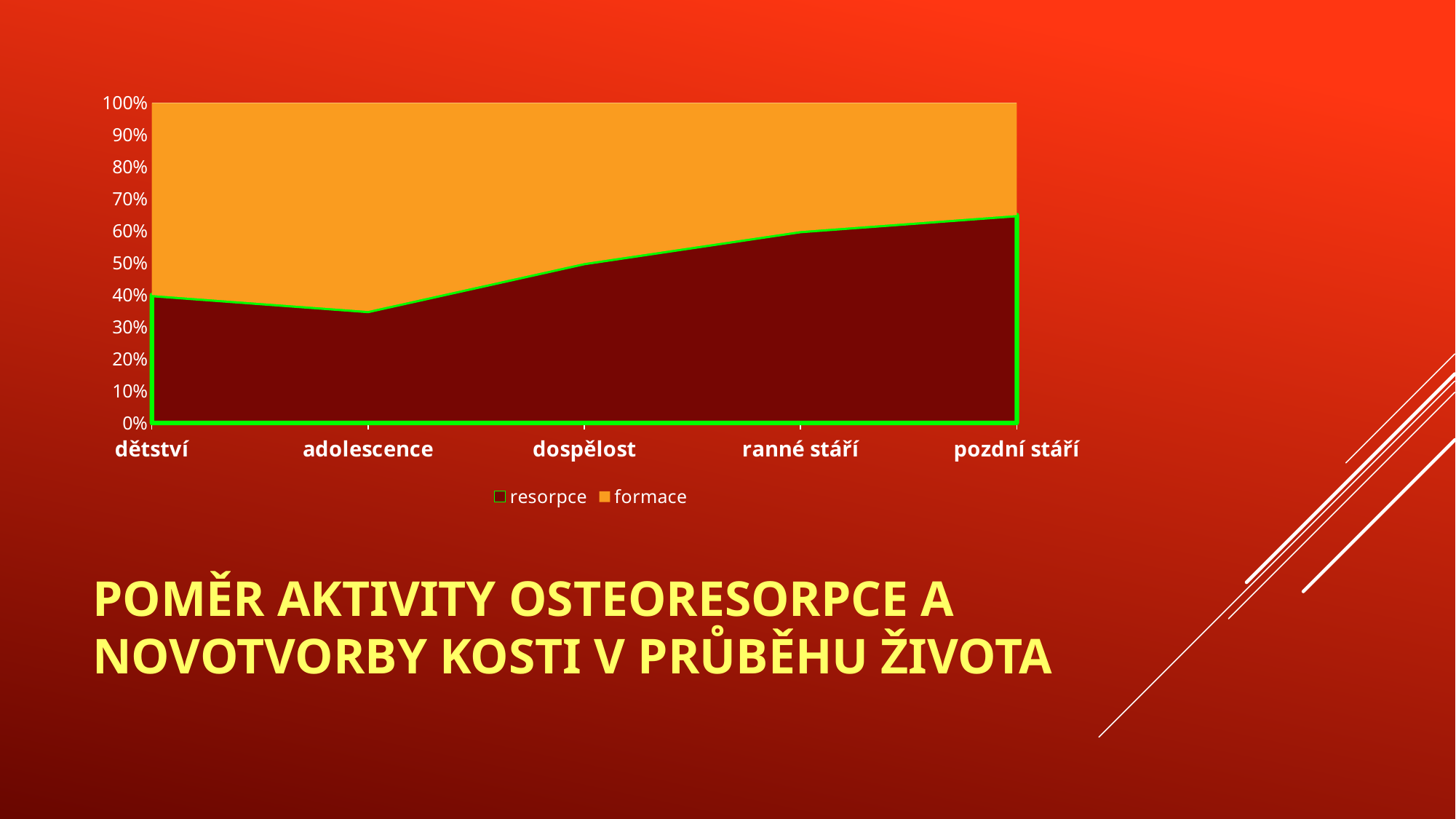
In which category is the share of resorpce lowest? adolescence What colour is the resorpce series? Dark red In which category is the share of resorpce highest? pozdní stáří How many series does the legend list? 2 Is the share of resorpce at dospělost greater or less than 40%? greater Which series are listed in the legend? resorpce and formace What kind of chart is shown on the slide? Stacked area chart Is the share of resorpce at pozdní stáří greater or less than 60%? greater Which has the larger share of resorpce, dětství or adolescence? dětství How many categories are shown along the x axis? 5 Is the share of resorpce at adolescence greater or less than 40%? less Does the share of resorpce rise or fall from adolescence to pozdní stáří? rise